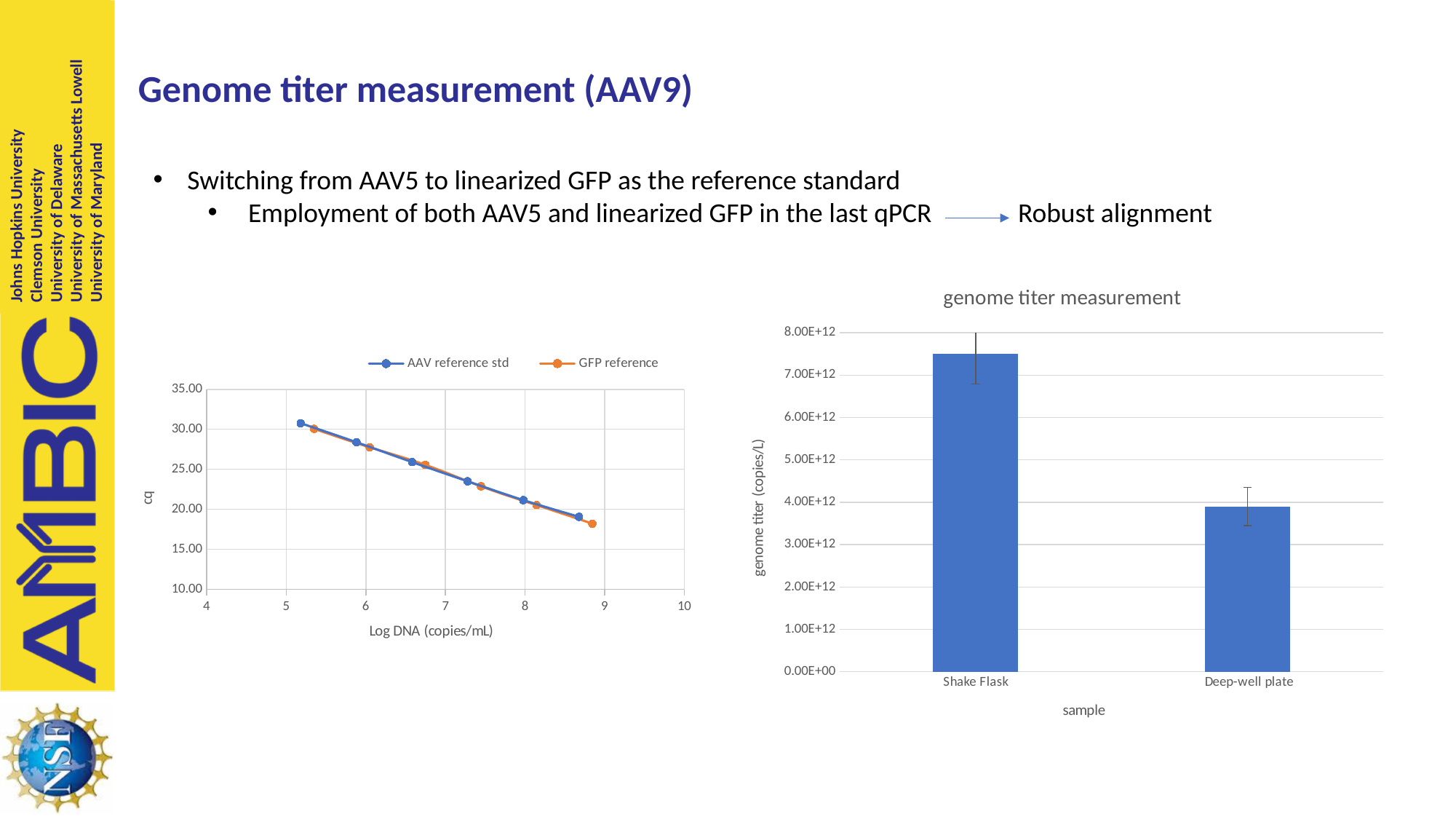
How many series does the legend of the left line chart list? 2 In the 'genome titer measurement' chart, is the value for Deep-well plate greater or less than 3.00E+12? greater In the 'genome titer measurement' chart, is the value for Shake Flask greater or less than 7.00E+12? greater In the 'genome titer measurement' chart, which sample has the highest genome titer? Shake Flask In the 'genome titer measurement' chart, is the value for Deep-well plate greater or less than 5.00E+12? less In the 'genome titer measurement' chart, which sample has the lowest genome titer? Deep-well plate How many samples are shown on the x axis of the 'genome titer measurement' chart? 2 In the 'genome titer measurement' chart, which is larger: Shake Flask or Deep-well plate? Shake Flask What is the y-axis label of the 'genome titer measurement' chart? genome titer (copies/L) In the left line chart, do the cq values rise or fall as Log DNA (copies/mL) increases? fall What type of chart is the chart on the right titled 'genome titer measurement'? bar chart What type of chart is the chart on the left with the 'Log DNA (copies/mL)' x axis? line chart